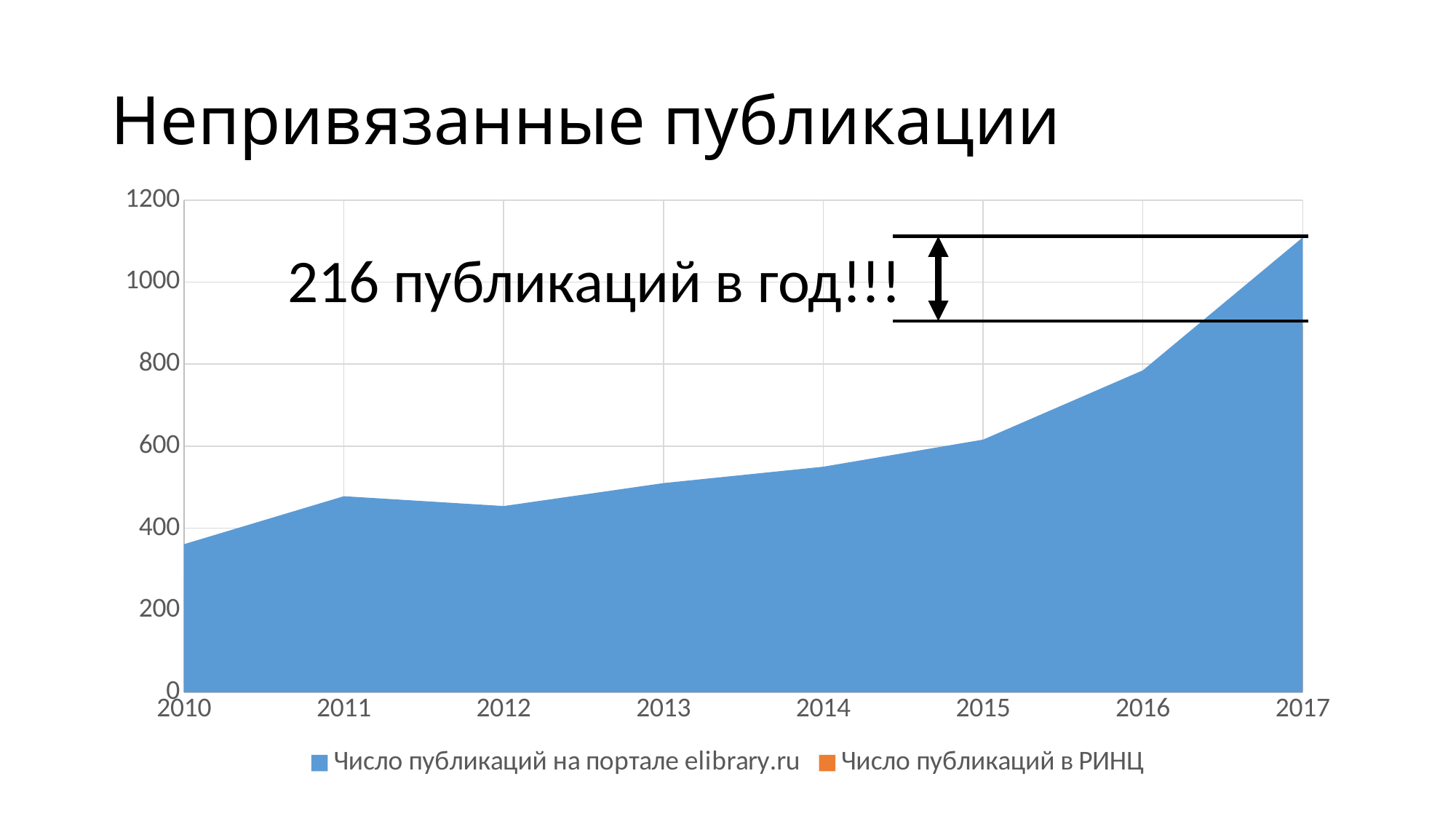
Is the value for 2017 greater or less than 1000? greater What kind of chart is shown on the slide? area chart How many years are plotted along the x axis? 8 What is the title of the slide? Непривязанные публикации How many series does the legend list? 2 What is the name of the blue series in the legend? Число публикаций на портале elibrary.ru Do the values for publications on elibrary.ru generally rise or fall from 2010 to 2017? rise Which year has the lowest number of publications on elibrary.ru? 2010 Which year has the highest number of publications on elibrary.ru? 2017 Is the value for 2010 greater or less than 400? less Which year has the larger value, 2011 or 2012? 2011